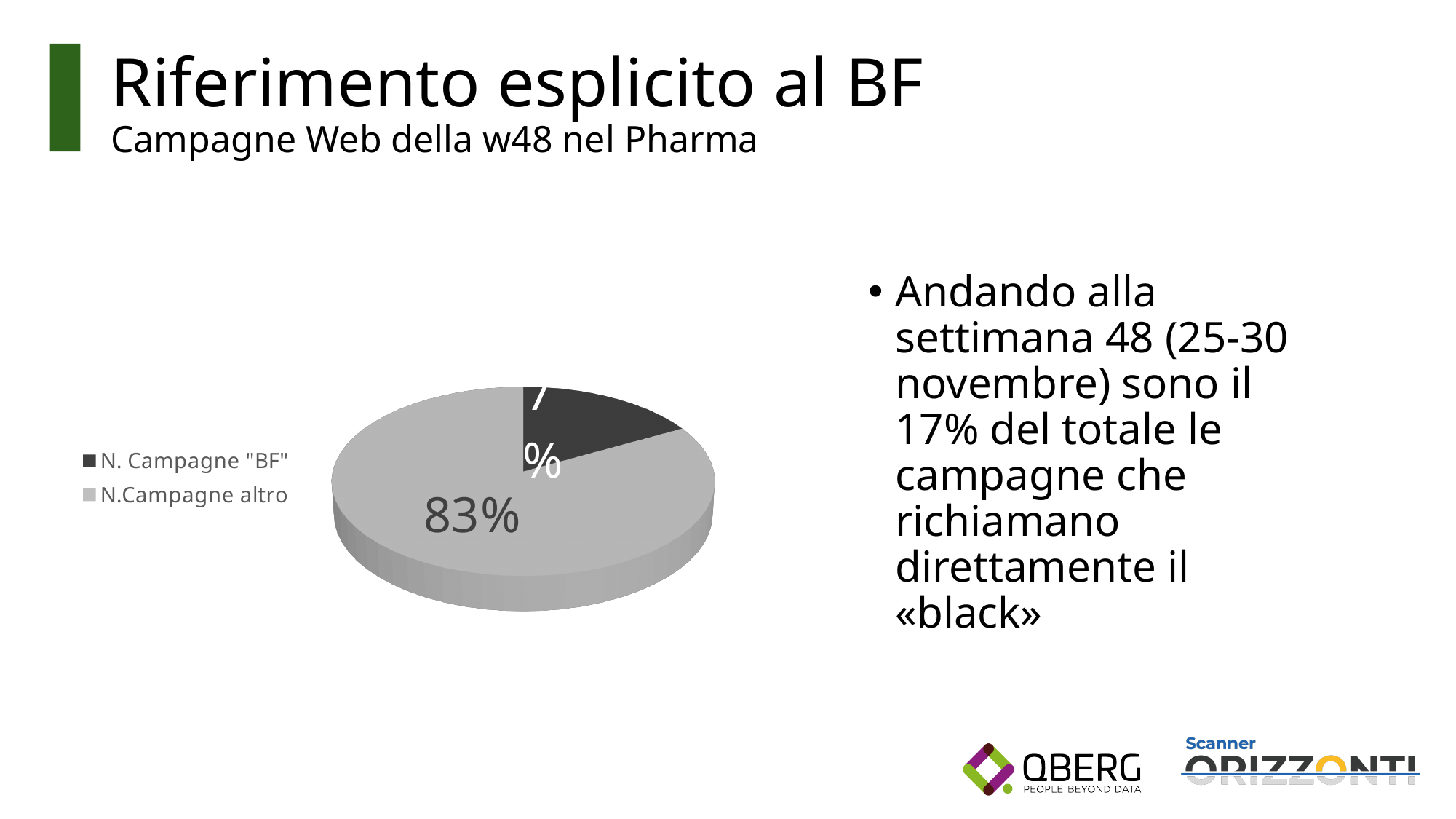
How many entries does the legend of the pie chart list? 2 What share of the pie does "N.Campagne altro" represent? 83% What colour is the slice for N. Campagne "BF" in the pie chart? dark grey Which is larger in the pie chart: N. Campagne "BF" or N.Campagne altro? N.Campagne altro According to the slide text, what percentage of the campaigns in week 48 refer directly to the "black" (BF)? 17% Is the share for N.Campagne altro greater or less than 50%? greater Which slice of the pie chart is the largest? N.Campagne altro What is the subtitle of the slide above the pie chart? Campagne Web della w48 nel Pharma Which slice of the pie chart is the smallest? N. Campagne "BF" What kind of chart is shown on the slide? pie chart Is the share for N. Campagne "BF" greater or less than 50%? less How many slices does the pie chart have? 2